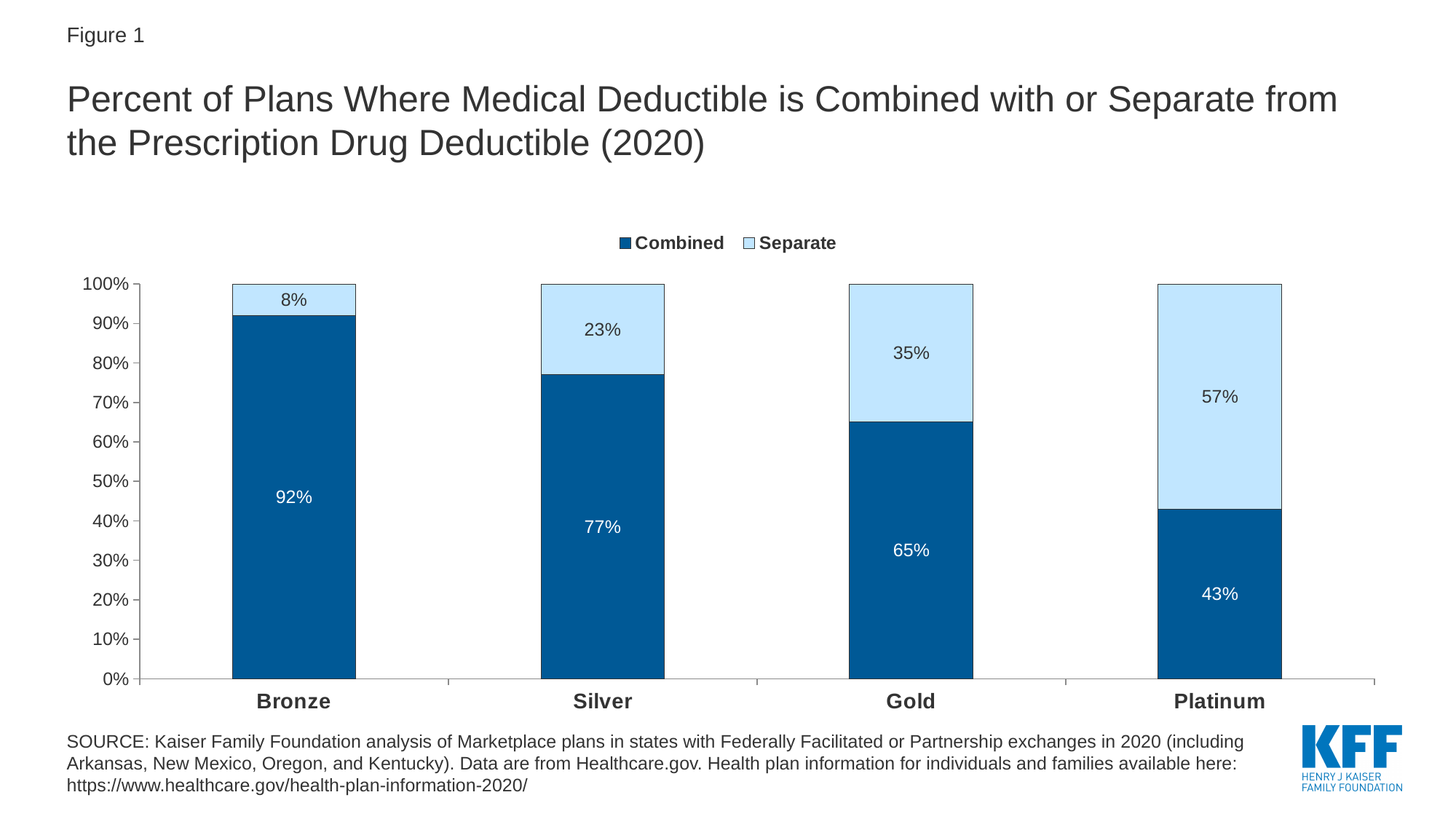
Which plan tier has the lowest Separate percentage? Bronze What is the difference between the Combined percentages for Silver and Gold plans? 12% What is the Separate value for Gold plans? 35% What percent of Bronze plans have a Combined deductible? 92% What is the total of the Combined and Separate segments for the Platinum bar? 100% Which plan tier has the highest Combined percentage? Bronze How many series does the legend list? 2 How many plan tiers are shown on the x axis? 4 What percent of Platinum plans have a Separate deductible? 57% Which is larger: the Separate value for Silver or the Separate value for Gold? Gold What kind of chart is shown on the slide? Stacked bar chart Do the Combined percentages rise or fall moving from Bronze to Platinum? Fall